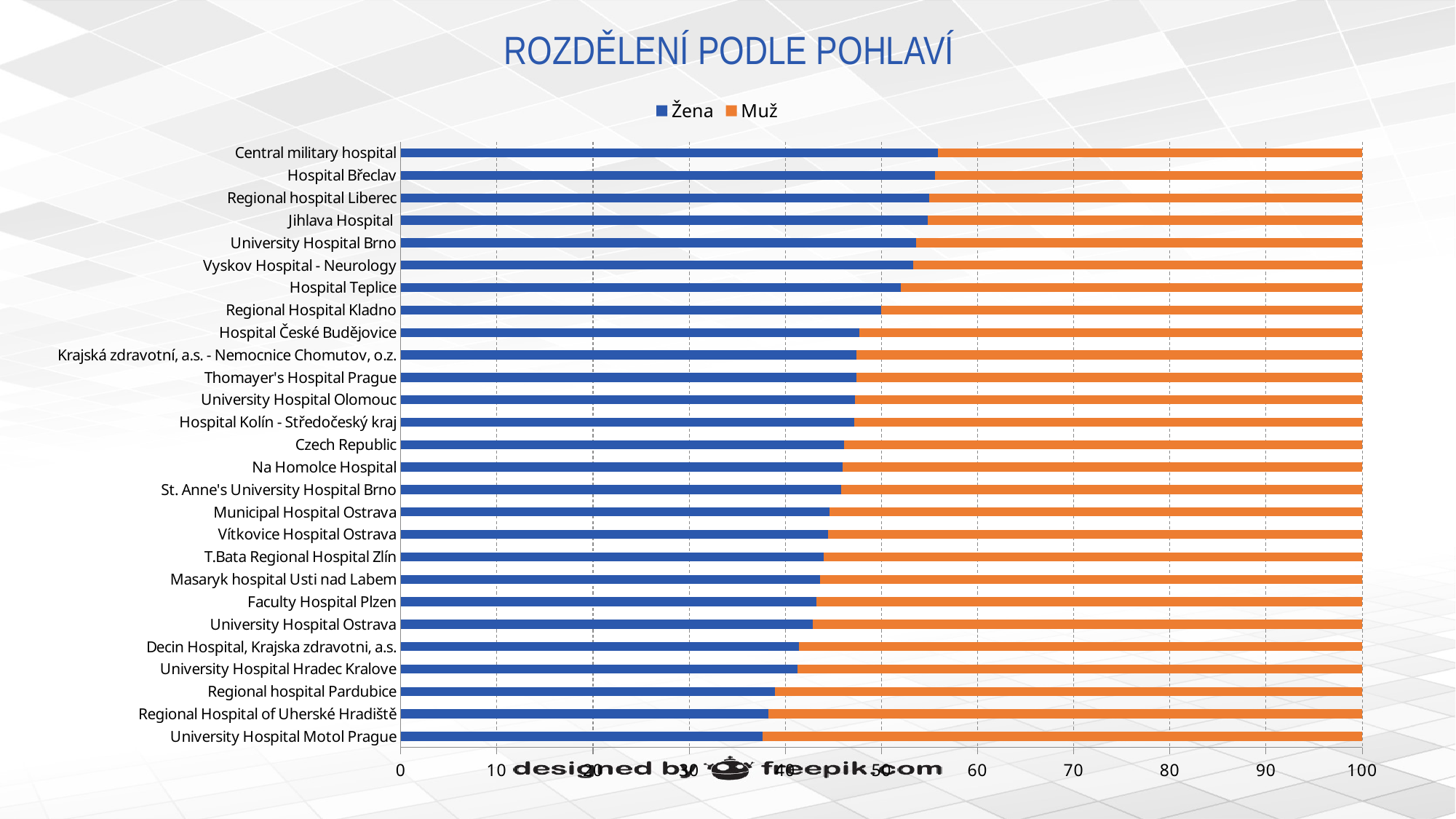
Which colour represents the Muž series? orange Which has a larger Muž share: Central military hospital or University Hospital Motol Prague? University Hospital Motol Prague Is the Žena value for Hospital České Budějovice greater or less than 50? less Is the Žena value for Central military hospital greater or less than 50? greater Which category has the lowest share for Žena? University Hospital Motol Prague What is the total of the stacked bar for Czech Republic? 100 Which category has the highest share for Žena? Central military hospital What is the title of the chart? ROZDĚLENÍ PODLE POHLAVÍ How many series does the legend list? 2 How many hospitals/categories are plotted on the chart? 27 Is the Žena value for University Hospital Motol Prague greater or less than 40? less What kind of chart is shown on the slide? bar chart